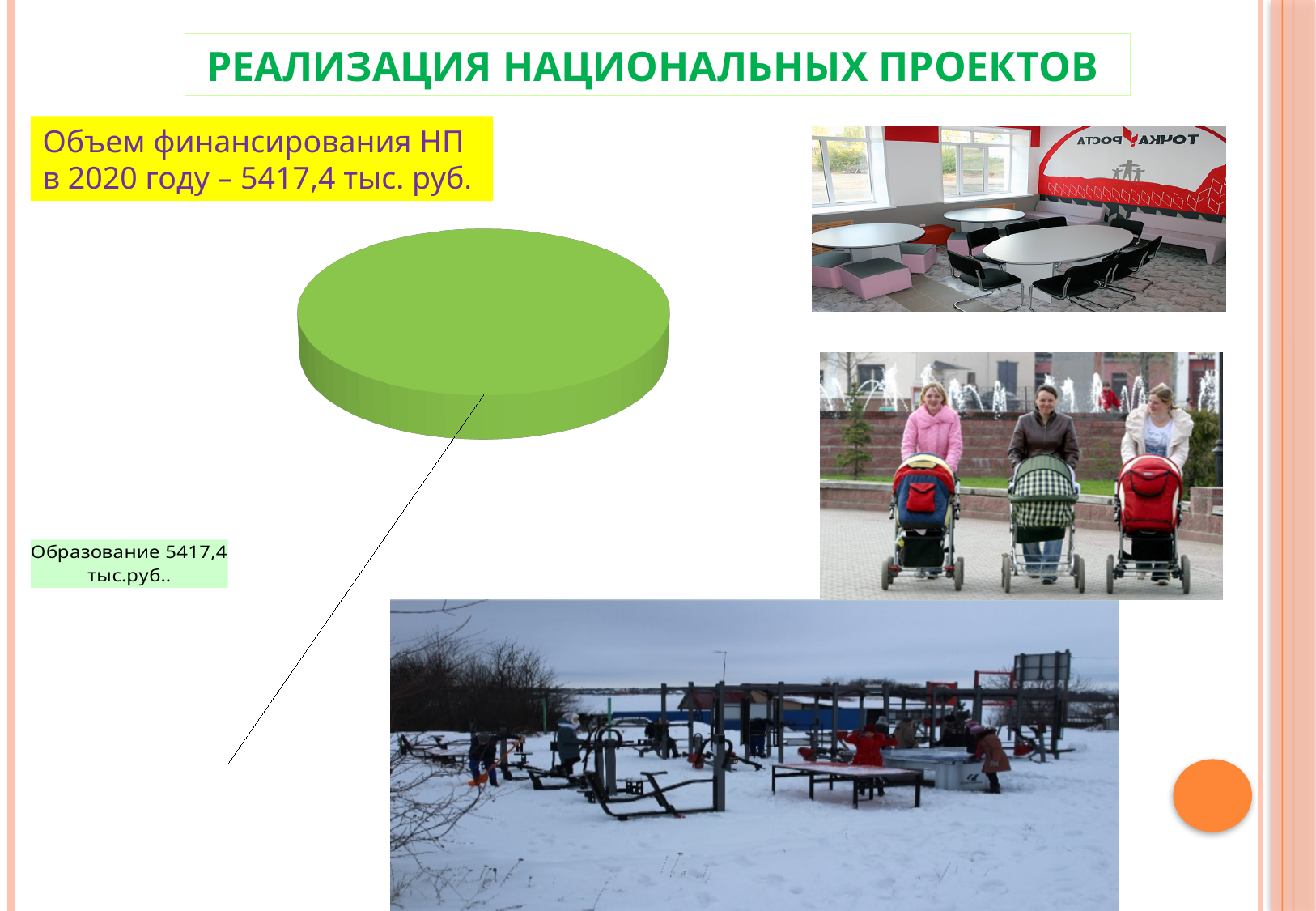
What value is shown for Образование in the pie chart? 5417,4 тыс.руб. Which category is labelled on the pie chart? Образование What colour is the Образование slice of the pie chart? green What share of the pie does the Образование slice represent? 100% According to the slide text, what was the total volume of national project financing in 2020? 5417,4 тыс. руб. How many slices does the pie chart have? 1 What kind of chart is shown on the slide? pie chart